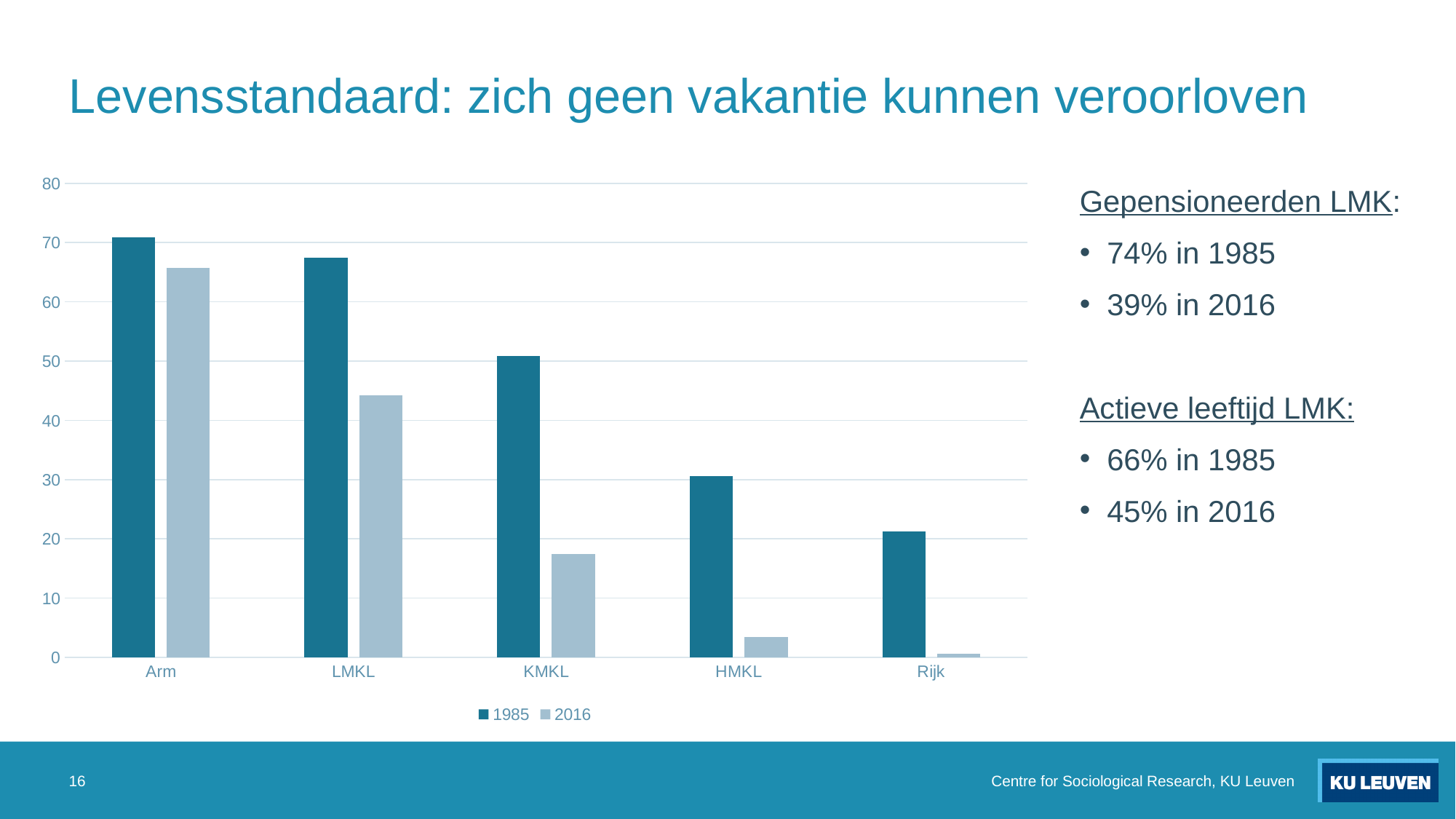
Which category has the lowest value for 2016? Rijk Which is larger for LMKL: the 1985 value or the 2016 value? 1985 Do the 2016 values rise or fall moving from Arm to Rijk along the x axis? fall How many categories are shown on the x axis of the chart? 5 Which series is shown in the darker blue colour in the chart? 1985 What kind of chart is shown on the slide? bar chart Which category has the highest value for 1985? Arm How many series does the chart legend list? 2 Is the value for KMKL in 2016 greater or less than 20? less Which category has the lowest value for 1985? Rijk